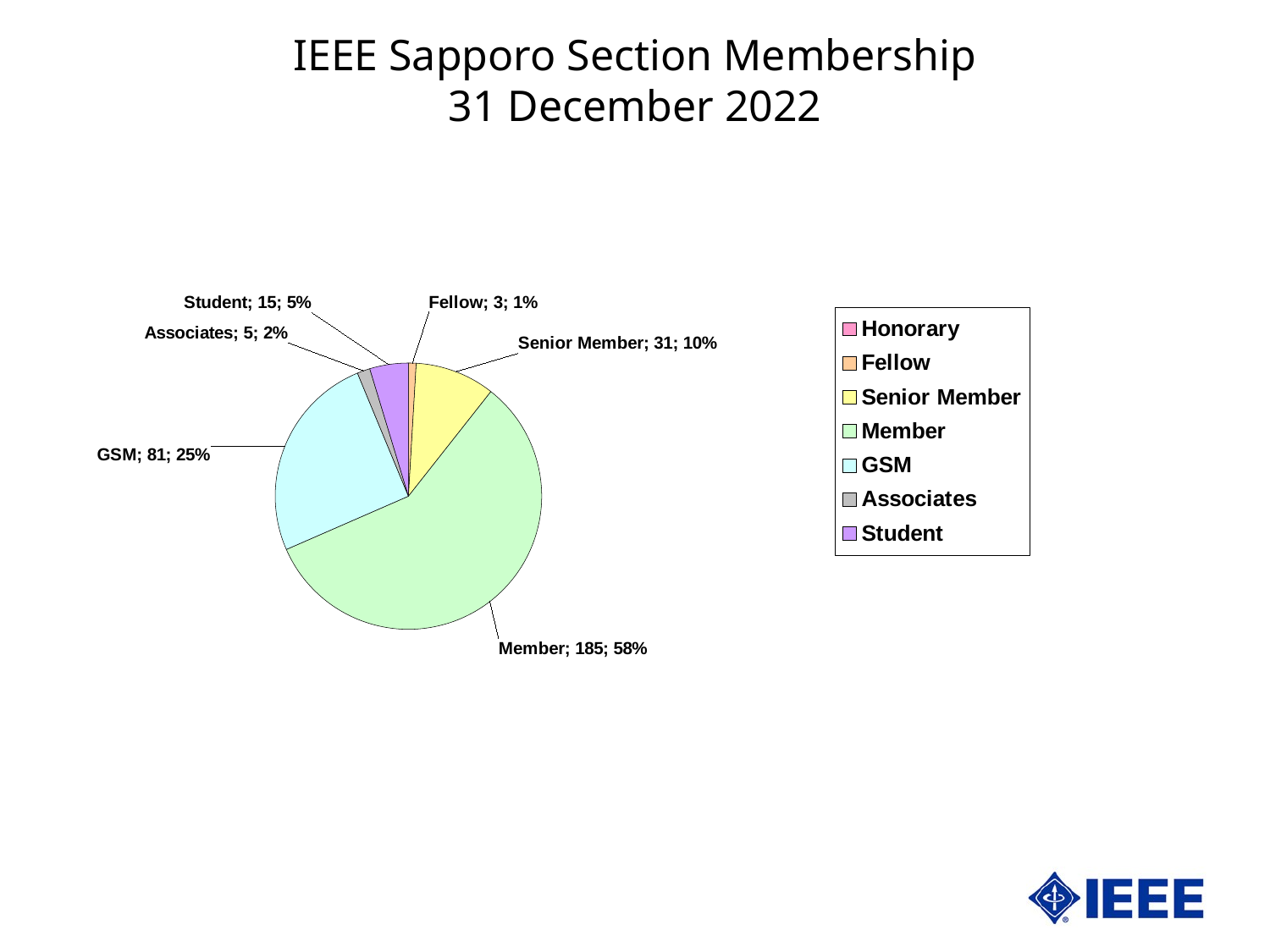
What is the difference between the number of Members and the number of GSM members? 104 Which category has the largest slice of the pie? Member How many members are in the Member category? 185 What is the title of the chart? IEEE Sapporo Section Membership 31 December 2022 Which is larger, the Senior Member count or the Student count? Senior Member What kind of chart is shown on the slide? pie chart How many Senior Members are there? 31 What share of the pie does the Student category represent? 5% How many entries does the legend list? 7 Which labelled category has the smallest slice of the pie? Fellow How many Associates are there? 5 What percentage of the membership is GSM? 25%